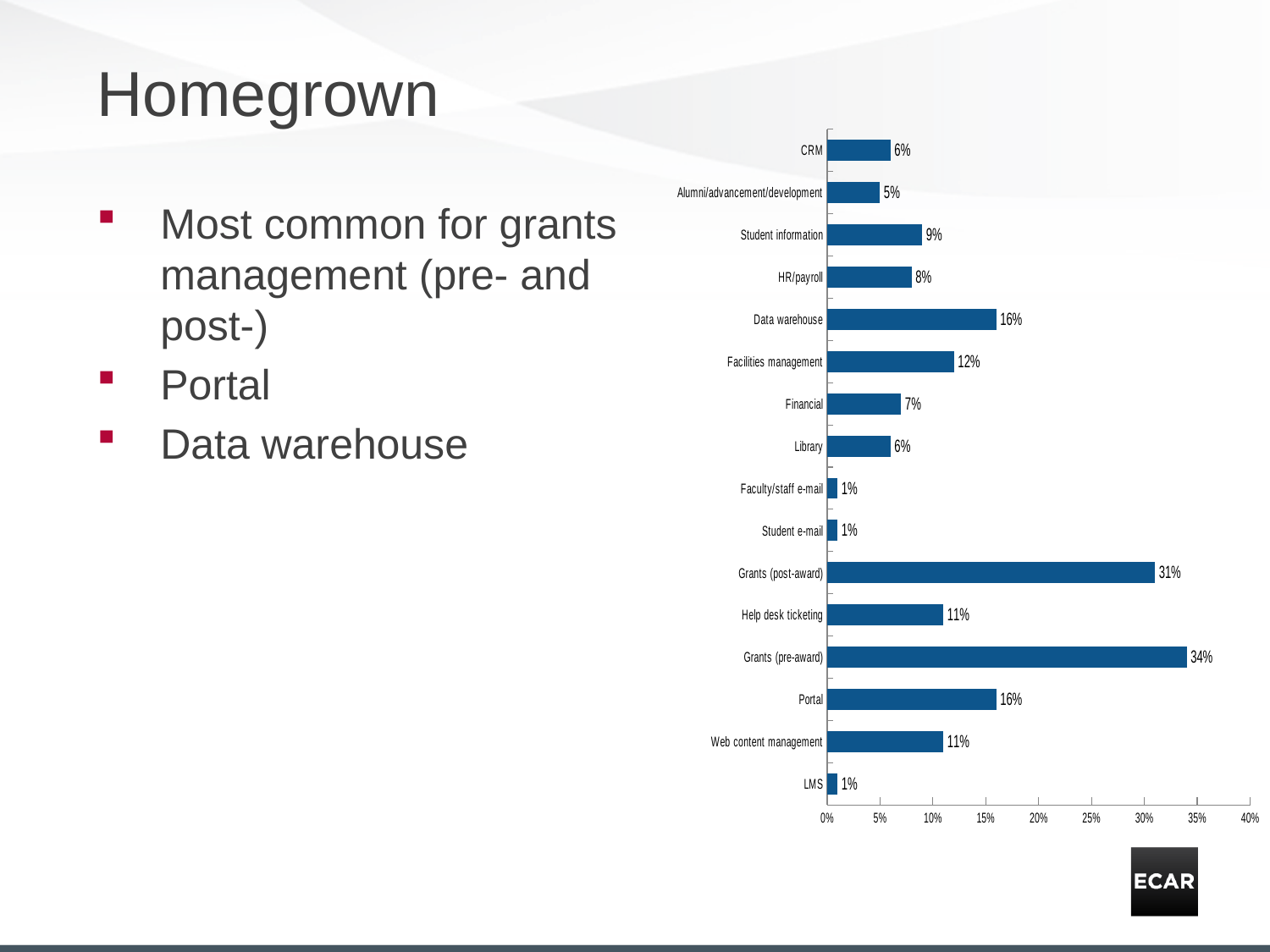
Is the value for Grants (post-award) greater or less than 25%? greater What kind of chart is shown on the slide? Bar chart What is the value for Alumni/advancement/development? 5% Which is larger, the value for Student information or the value for HR/payroll? Student information What is the value for Data warehouse? 16% What is the difference between the values for Facilities management and Financial? 5% Which is larger, the value for Portal or the value for Web content management? Portal What is the value for Grants (post-award)? 31% What is the value for Help desk ticketing? 11% What is the difference between the values for Grants (pre-award) and Grants (post-award)? 3% How many categories are shown in the chart? 16 Which category has the highest value? Grants (pre-award)